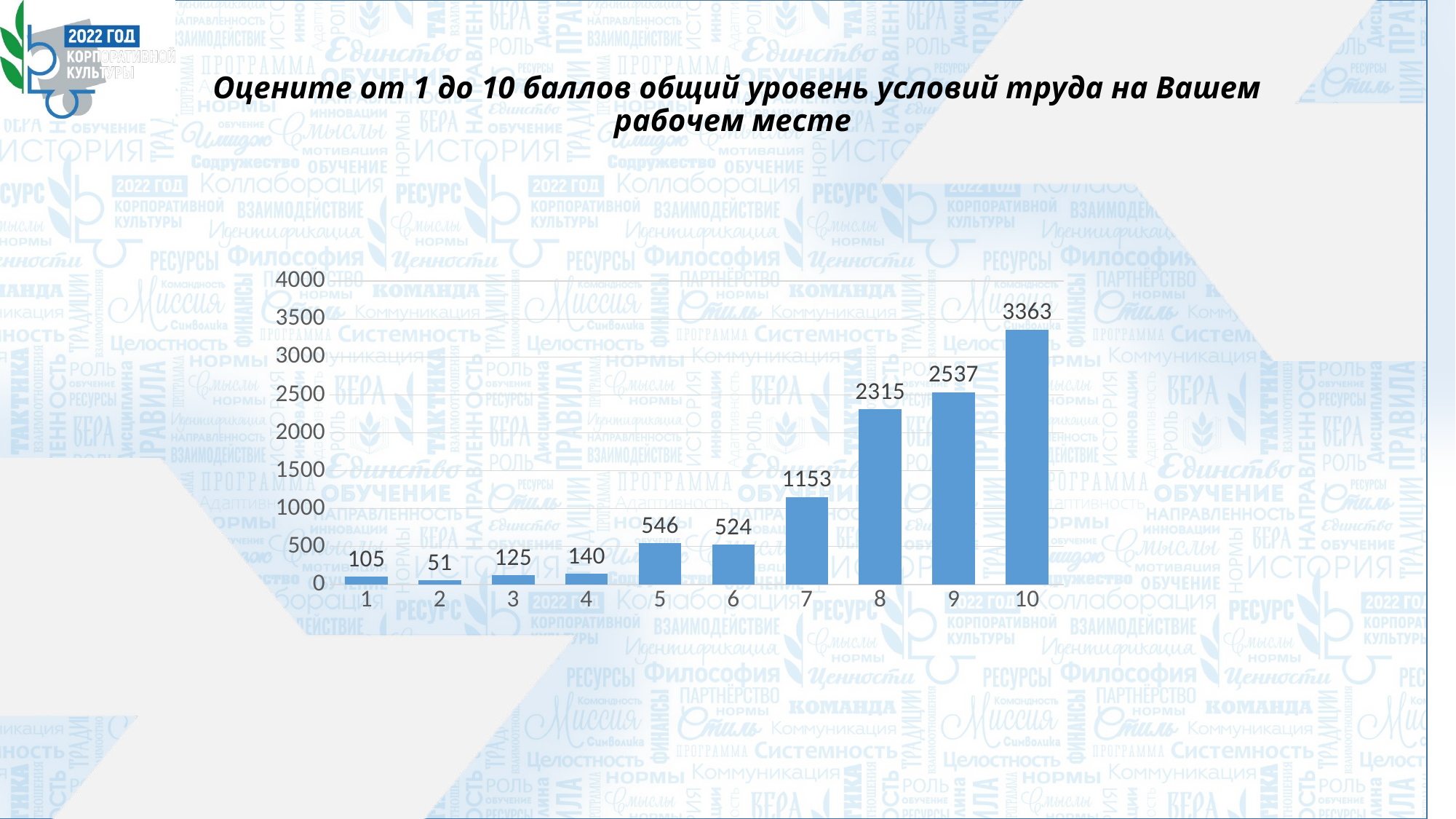
What value is shown for category 2? 51 Which category has the highest value? 10 What is the difference between the values for category 10 and category 9? 826 Do the values generally rise or fall from category 4 to category 10? rise What is the difference between the values for category 5 and category 6? 22 How many categories are shown on the x axis? 10 What kind of chart is shown on the slide? bar chart Which is larger, the value for category 8 or the value for category 7? 8 Which category has the lowest value? 2 What value is shown for category 9? 2537 Is the value for category 8 greater or less than 2000? greater What value is shown for category 7? 1153